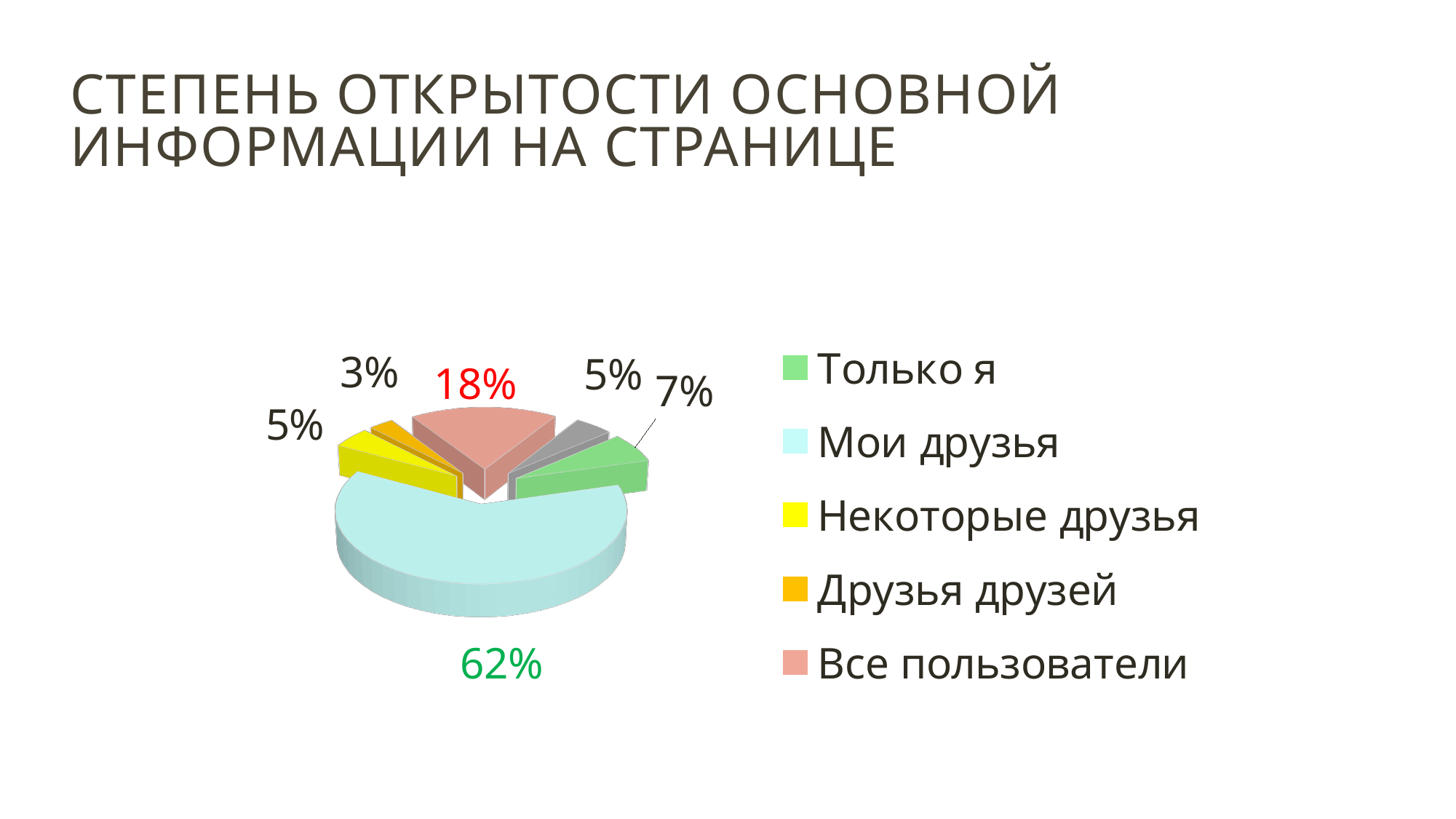
Which category has the largest share of the pie? Мои друзья What is the value shown for "Все пользователи"? 18% What percentage is shown for "Друзья друзей"? 3% By how many percentage points does "Мои друзья" exceed "Все пользователи"? 44 percentage points What kind of chart is shown on the slide? Pie chart Which is larger, the share for "Только я" or the share for "Все пользователи"? Все пользователи What percentage of the pie does "Мои друзья" account for? 62% How many entries does the chart legend list? 5 What colour is the slice for "Все пользователи"? Pink What is the value for "Некоторые друзья"? 5% What percentage is shown for "Только я"? 7% Which legend category has the smallest share of the pie? Друзья друзей